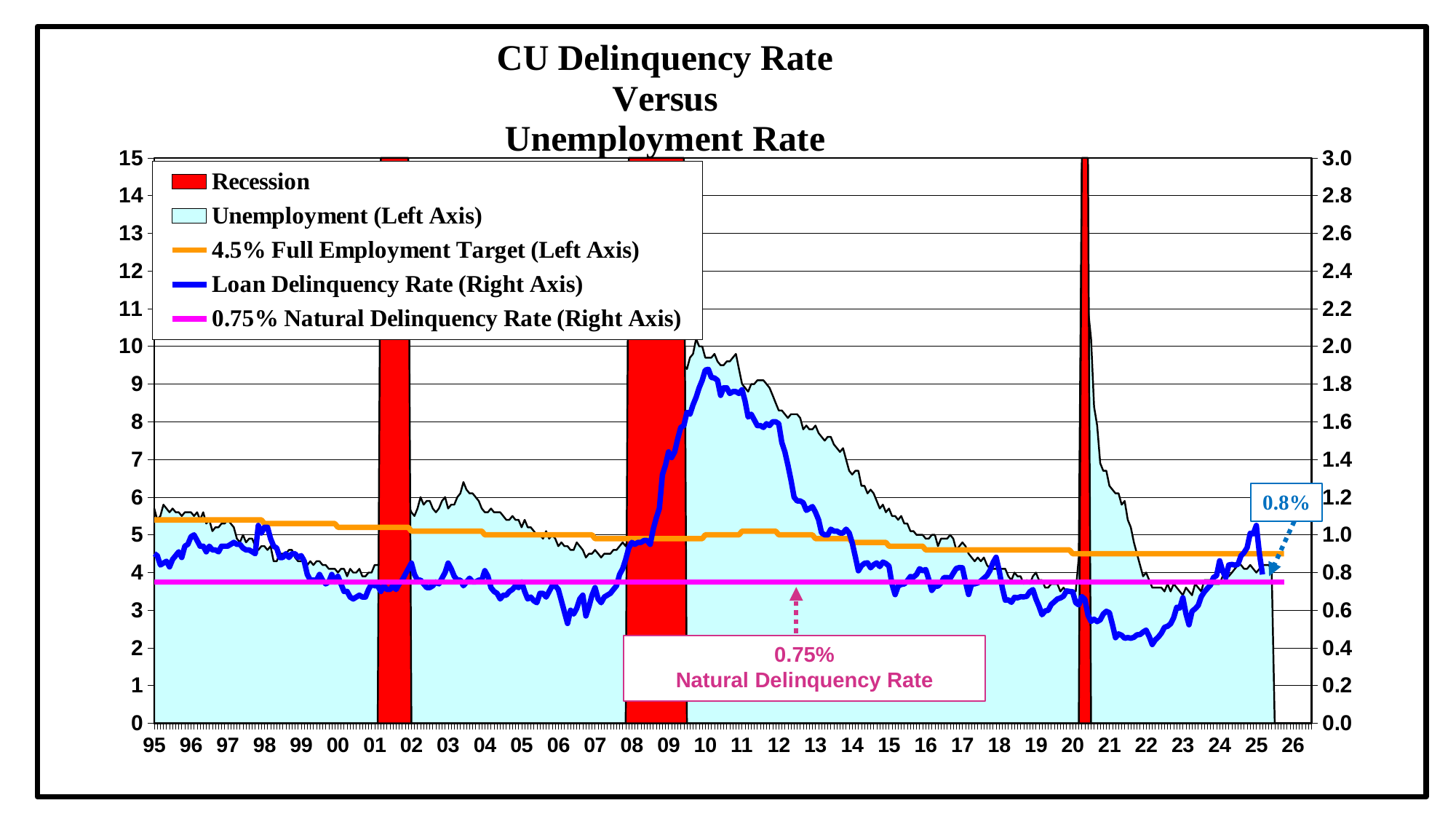
Was the Loan Delinquency Rate higher in 2010 or in 2022? 2010 How many entries does the legend list? 5 What is the title of the chart? CU Delinquency Rate Versus Unemployment Rate What value is the Full Employment Target line set at? 4.5% On which axis is the Loan Delinquency Rate plotted? Right axis In which year does the Loan Delinquency Rate reach its highest point? 10 Is the Loan Delinquency Rate in 2022 greater or less than 0.6 on the right axis? less What is the most recent Loan Delinquency Rate value labelled on the chart? 0.8% Is the peak unemployment rate around 2020 greater or less than 10 on the left axis? greater What value is the Natural Delinquency Rate line set at? 0.75% Does the unemployment rate rise or fall between 2010 and 2019? fall How many recession periods are shaded on the chart? 3